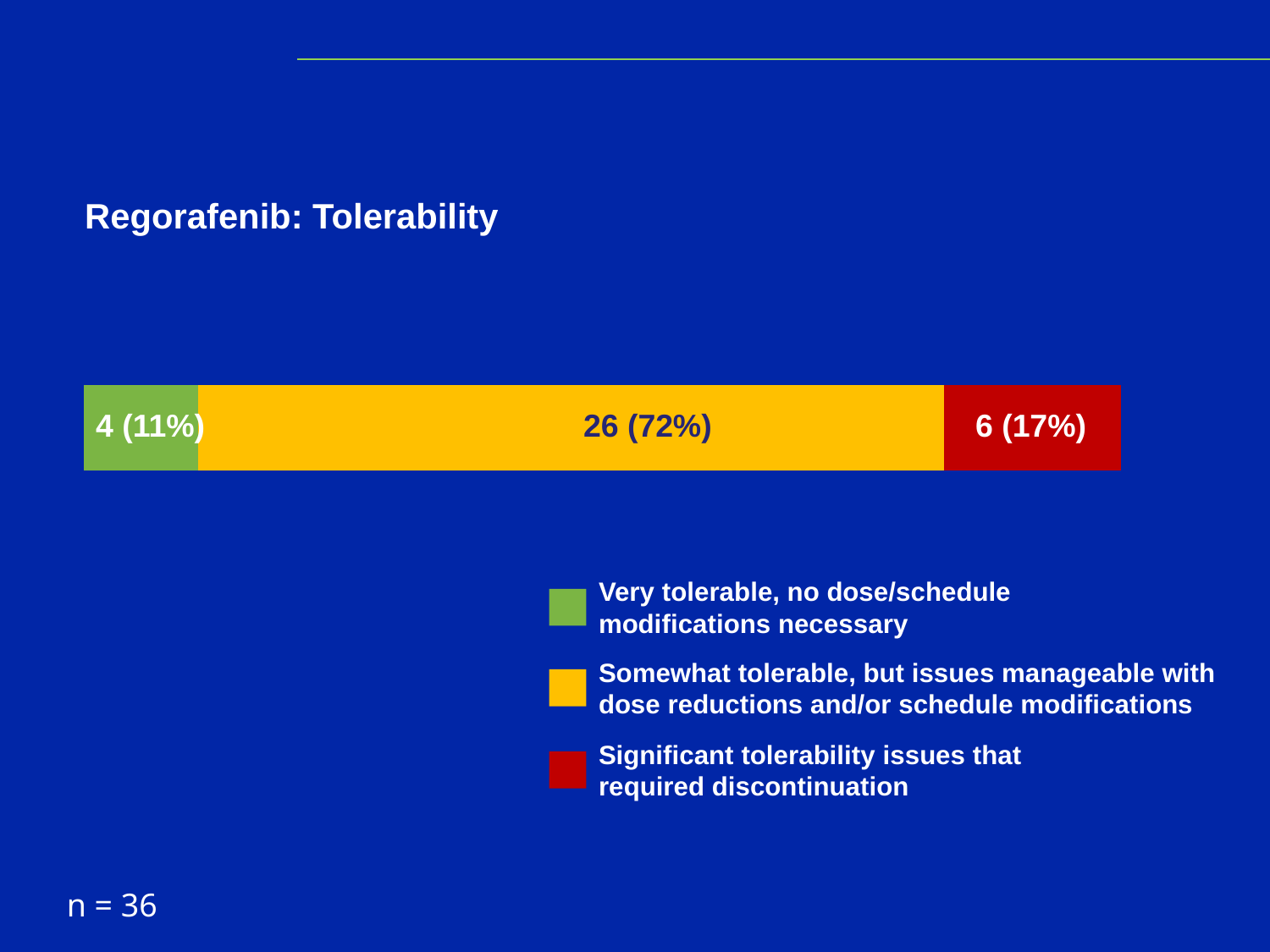
Which tolerability category has the largest number of patients? Somewhat tolerable, but issues manageable with dose reductions and/or schedule modifications What is the value shown for the 'Somewhat tolerable, but issues manageable with dose reductions and/or schedule modifications' segment? 26 (72%) What is the value shown for the 'Significant tolerability issues that required discontinuation' segment? 6 (17%) What colour represents the 'Significant tolerability issues that required discontinuation' category? Red What is the total number of patients across all three segments of the bar? 36 How many entries does the legend list? 3 How many segments make up the stacked bar? 3 Which tolerability category has the smallest number of patients? Very tolerable, no dose/schedule modifications necessary What is the value shown for the 'Very tolerable, no dose/schedule modifications necessary' segment? 4 (11%) What kind of chart is shown on the slide? Stacked bar chart Which has more patients: 'Very tolerable' or 'Significant tolerability issues that required discontinuation'? Significant tolerability issues that required discontinuation How many more patients were in the 'Somewhat tolerable' category than in the 'Significant tolerability issues' category? 20